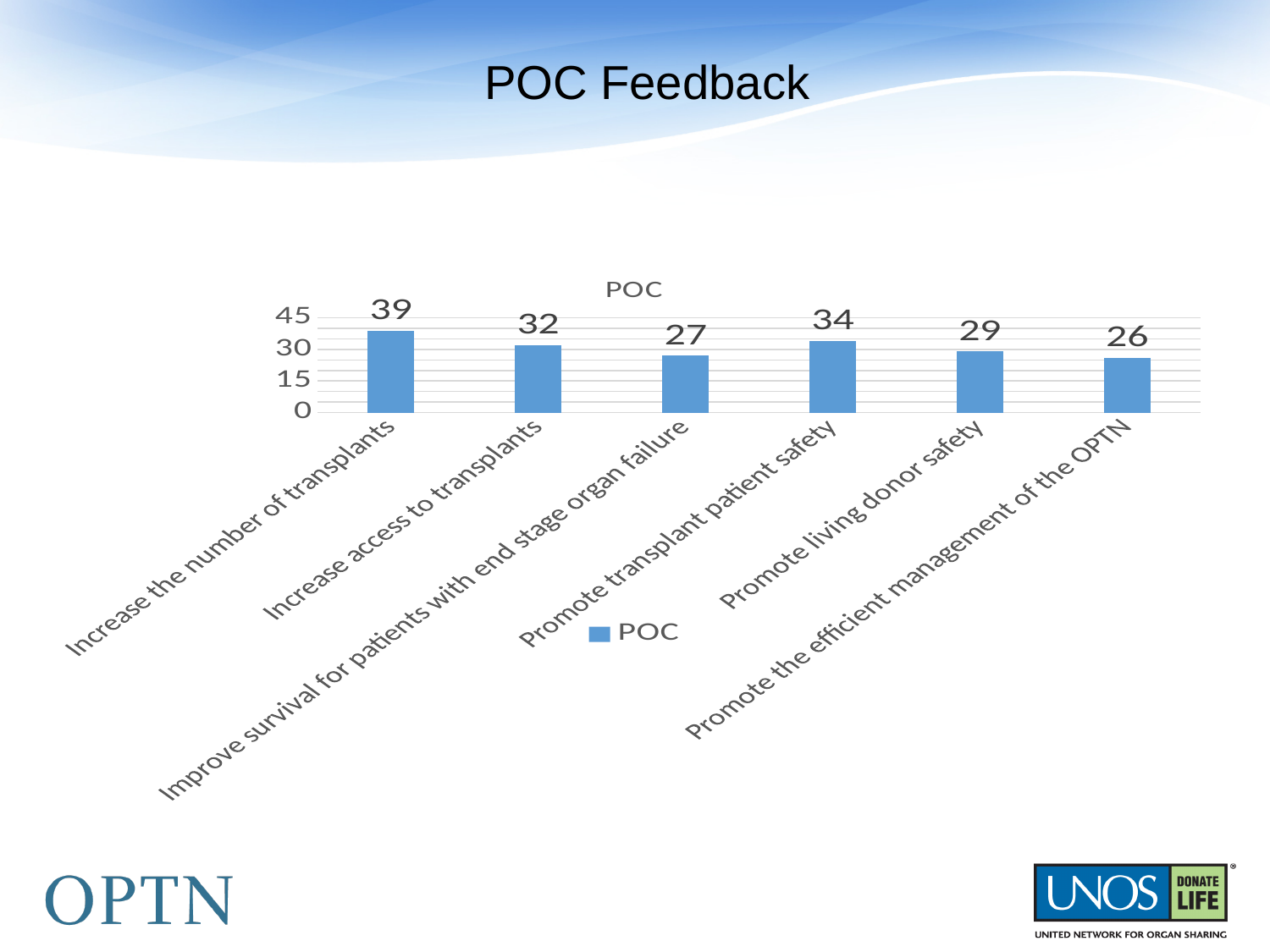
What is the difference between the values for "Increase the number of transplants" and "Promote the efficient management of the OPTN"? 13 How many categories are shown in the chart? 6 Is the value for "Promote living donor safety" greater or less than 30? less What kind of chart is shown on the slide? bar chart What is the value for "Improve survival for patients with end stage organ failure"? 27 Which is larger, the value for "Increase access to transplants" or the value for "Promote transplant patient safety"? Promote transplant patient safety Which category has the lowest value? Promote the efficient management of the OPTN How many series does the legend list? 1 Which category has the highest value? Increase the number of transplants What is the title of the chart? POC What is the value for "Increase the number of transplants"? 39 What is the value for "Promote living donor safety"? 29